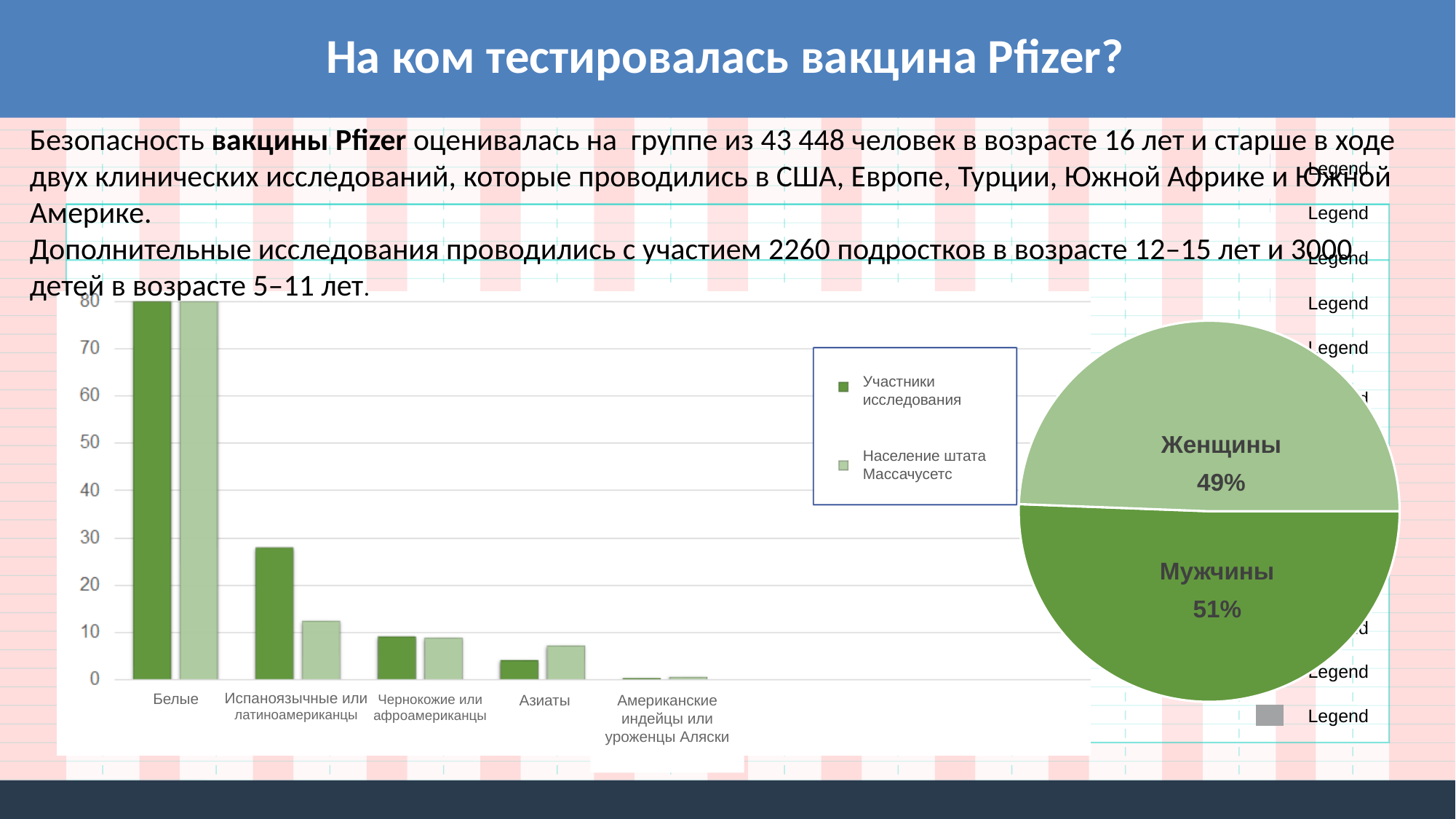
In the pie chart, what share is shown for Женщины? 49% In the bar chart on the left, for Испаноязычные или латиноамериканцы, which series has the larger value, Участники исследования or Население штата Массачусетс? Участники исследования In the bar chart on the left, how many series does the legend list? 2 In the bar chart on the left, is the value for Испаноязычные или латиноамериканцы in the Участники исследования series greater or less than 20? greater In the bar chart on the left, which category has the lowest value for Участники исследования? Американские индейцы или уроженцы Аляски In the pie chart, how many slices are there? 2 What kind of chart is the chart on the left side of the slide? Bar chart In the bar chart on the left, how many categories are shown on the x axis? 5 In the pie chart, what is the difference in percentage points between Мужчины and Женщины? 2 percentage points In the pie chart, which slice is larger, Женщины or Мужчины? Мужчины In the pie chart, what share is shown for Мужчины? 51% In the bar chart on the left, which category has the highest value for Участники исследования? Белые